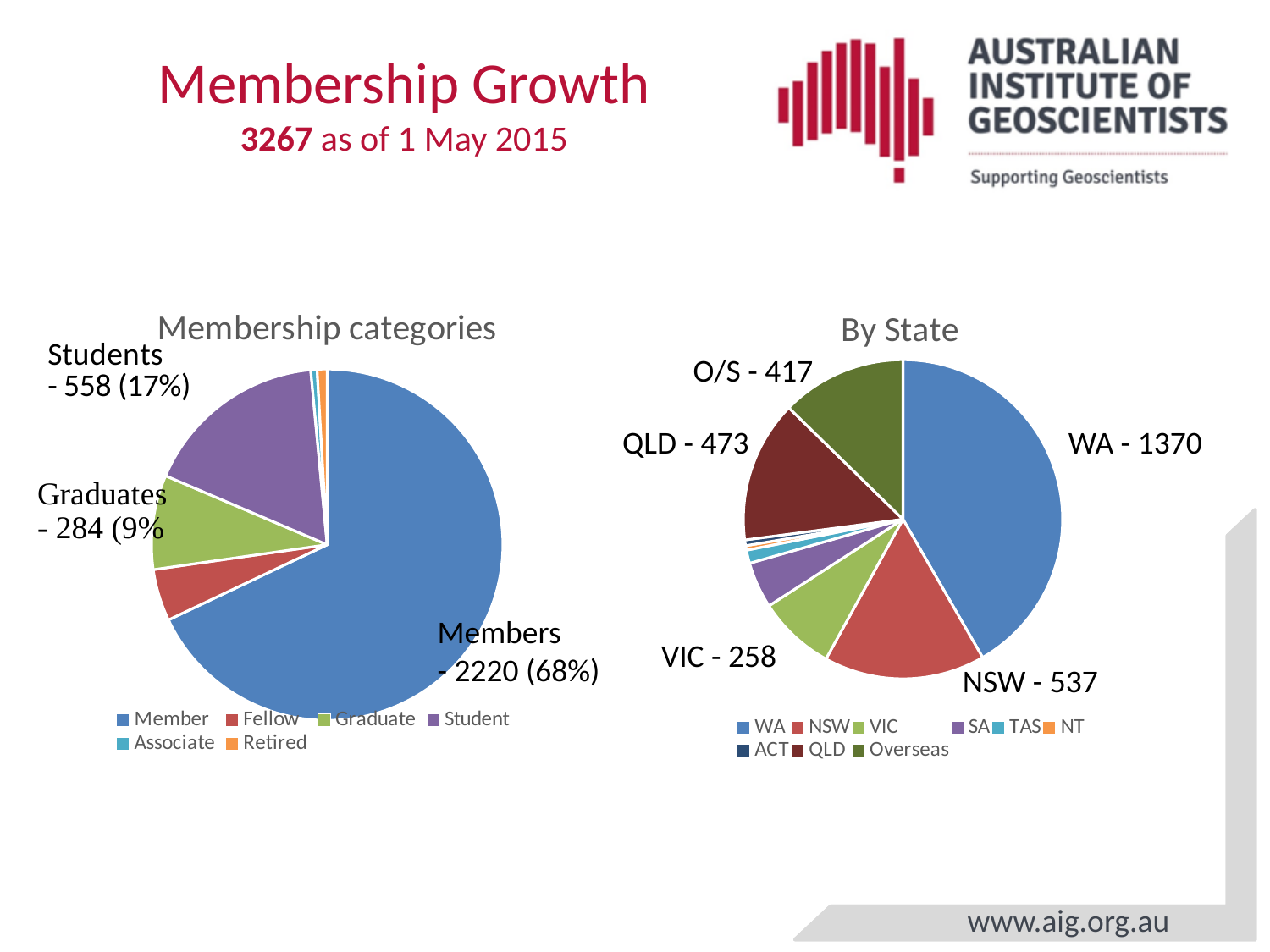
In the 'By State' chart, which state has the largest slice? WA How many categories does the legend of the 'By State' chart list? 9 How many categories does the legend of the 'Membership categories' chart list? 6 In the 'Membership categories' chart, how many members are in the Students category? 558 In the 'Membership categories' chart, what share of the pie do Members make up? 68% What type of chart is the 'Membership categories' chart? Pie chart In the 'By State' chart, what is the value for NSW? 537 In the 'By State' chart, which is larger, QLD or O/S? QLD In the 'By State' chart, what is the value for QLD? 473 In the 'Membership categories' chart, what is the difference between the Members and Students values? 1662 In the 'By State' chart, what is the value for WA? 1370 In the 'By State' chart, what is the difference between the WA and NSW values? 833